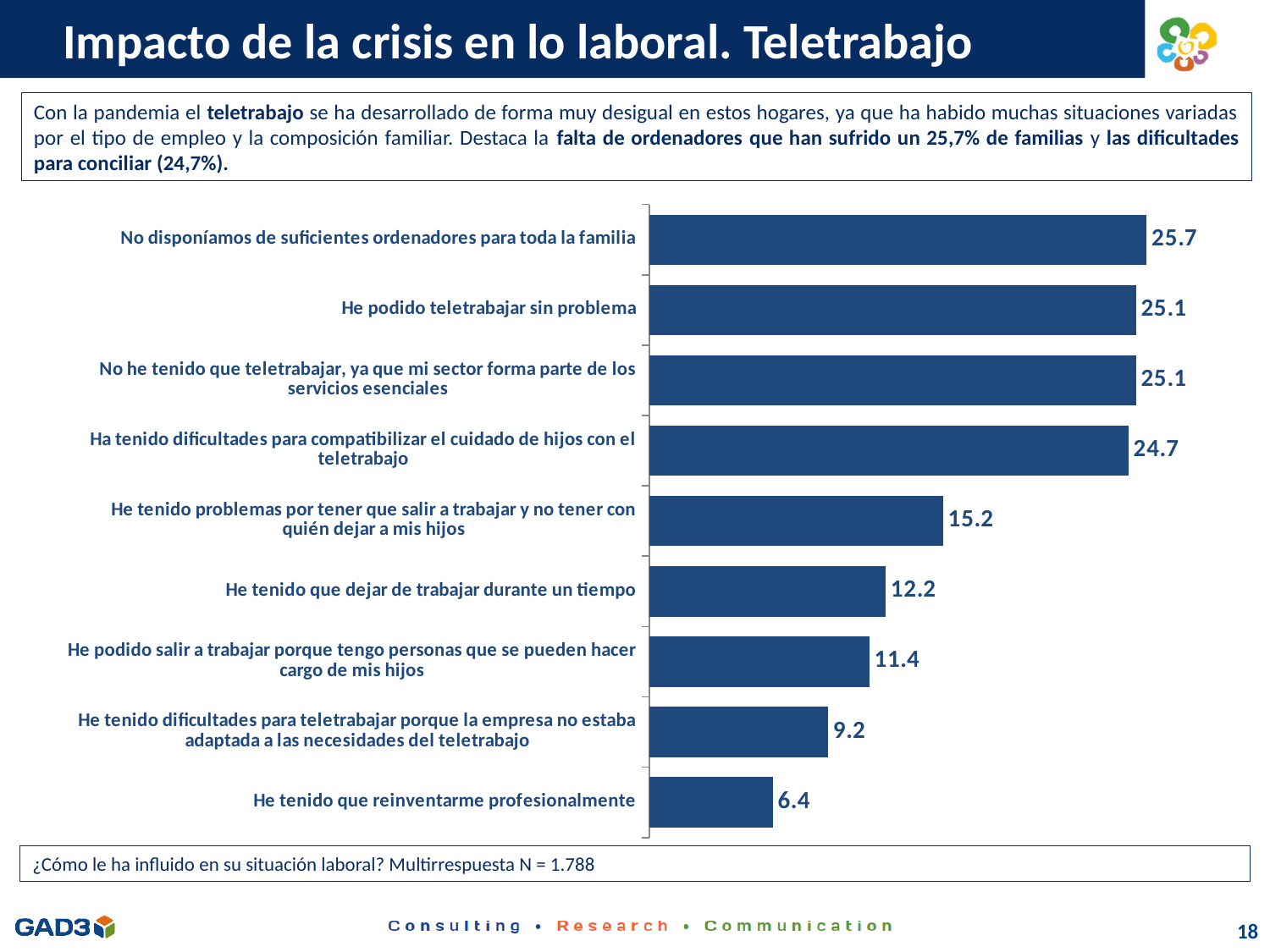
What is the value for "He tenido dificultades para teletrabajar porque la empresa no estaba adaptada a las necesidades del teletrabajo"? 9.2 What is the sample size (N) stated below the chart? 1.788 How many categories are shown in the chart? 9 What is the difference between the values for "He tenido que dejar de trabajar durante un tiempo" and "He podido salir a trabajar porque tengo personas que se pueden hacer cargo de mis hijos"? 0.8 What kind of chart is shown on the slide? Bar chart Which is larger: the value for "He tenido que dejar de trabajar durante un tiempo" or the value for "He tenido dificultades para teletrabajar porque la empresa no estaba adaptada a las necesidades del teletrabajo"? He tenido que dejar de trabajar durante un tiempo What is the value for "No disponíamos de suficientes ordenadores para toda la familia"? 25.7 What is the difference between the highest and lowest values in the chart? 19.3 What is the value for "He tenido que reinventarme profesionalmente"? 6.4 Which category has the highest value? No disponíamos de suficientes ordenadores para toda la familia What is the value for "He tenido problemas por tener que salir a trabajar y no tener con quién dejar a mis hijos"? 15.2 Which category has the lowest value? He tenido que reinventarme profesionalmente